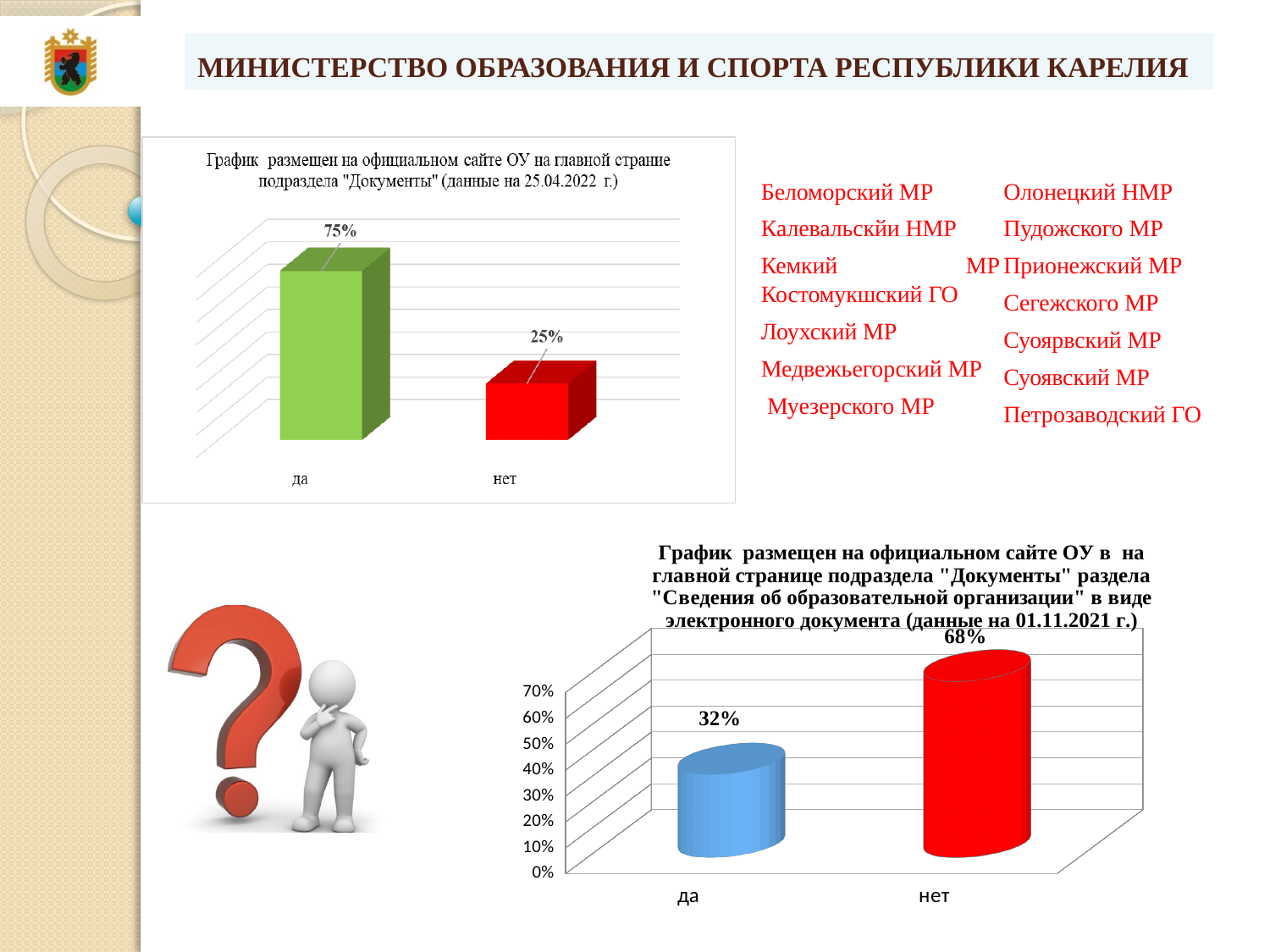
In the bottom-right chart (data on 01.11.2021), what is the value for "да"? 32% In the top-left chart (data on 25.04.2022), which category has the highest value? да In the top-left chart (data on 25.04.2022), what is the difference between the values for "да" and "нет"? 50% What kind of chart is the top-left chart (data on 25.04.2022)? bar chart In the bottom-right chart (data on 01.11.2021), what is the value for "нет"? 68% In the bottom-right chart (data on 01.11.2021), what colour is the bar for "нет"? red In the top-left chart (data on 25.04.2022), what is the value for "нет"? 25% In the bottom-right chart (data on 01.11.2021), which category has the lowest value? да In the bottom-right chart (data on 01.11.2021), is the value for "нет" greater or less than 50%? greater In the bottom-right chart (data on 01.11.2021), what is the difference between the values for "нет" and "да"? 36% In the top-left chart (data on 25.04.2022), how many categories are shown? 2 In the top-left chart (data on 25.04.2022), what is the value for "да"? 75%